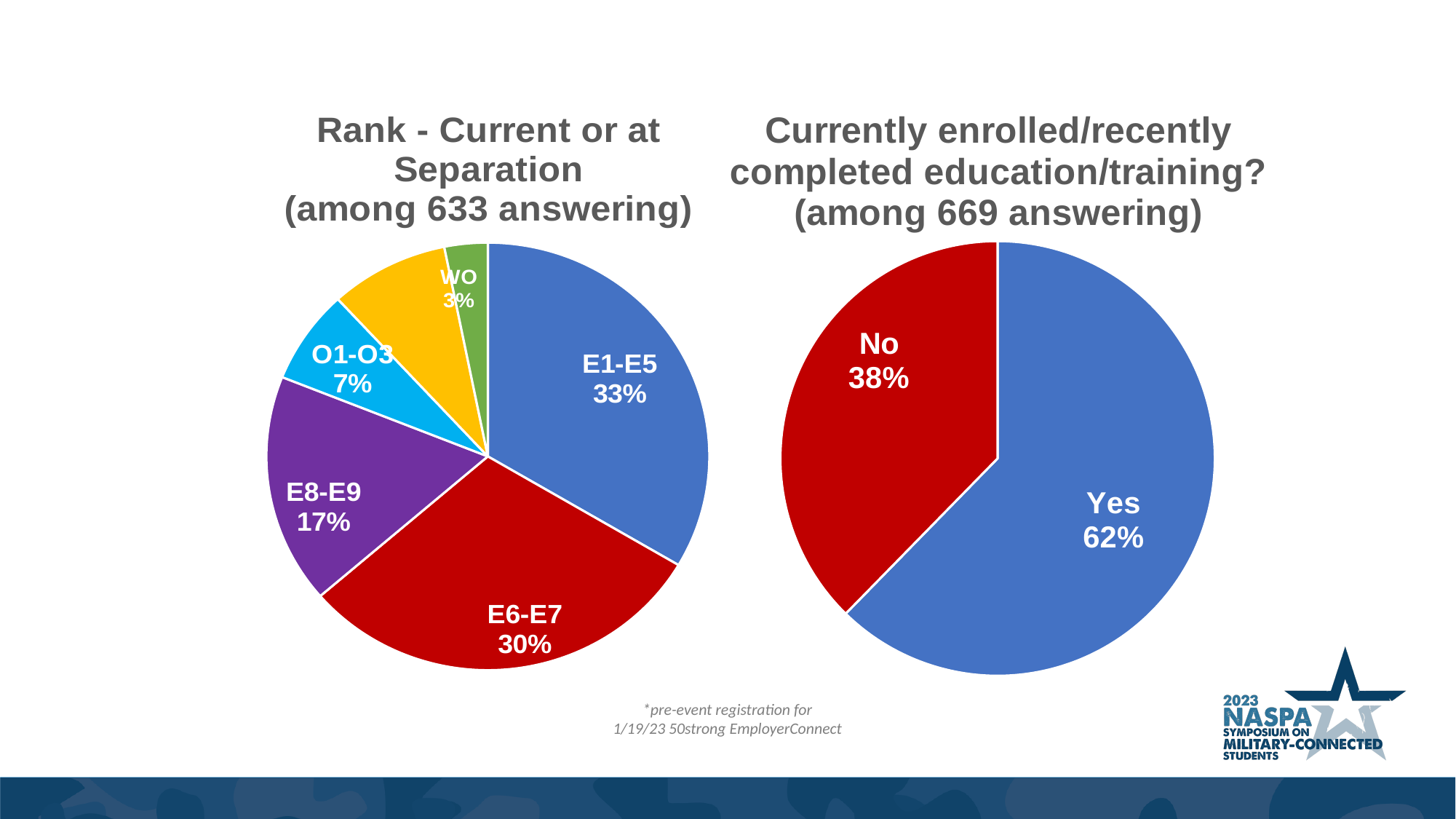
In the 'Currently enrolled/recently completed education/training?' chart, what percentage answered Yes? 62% In the 'Rank - Current or at Separation' chart, which is larger, E8-E9 or O1-O3? E8-E9 In the 'Rank - Current or at Separation' chart, which rank group has the smallest slice? WO What type of chart is used for 'Rank - Current or at Separation'? Pie chart In the 'Rank - Current or at Separation' chart, what is the difference in percentage points between E6-E7 and O1-O3? 23 How many respondents answered the 'Currently enrolled/recently completed education/training?' question, according to the chart title? 669 In the 'Rank - Current or at Separation' chart, how many rank categories are shown? 6 In the 'Rank - Current or at Separation' chart, which rank group has the largest slice? E1-E5 In the 'Currently enrolled/recently completed education/training?' chart, what percentage answered No? 38% In the 'Rank - Current or at Separation' chart, what share of respondents are E1-E5? 33% In the 'Currently enrolled/recently completed education/training?' chart, what is the difference in percentage points between Yes and No? 24 In the 'Rank - Current or at Separation' chart, what percentage is shown for E8-E9? 17%